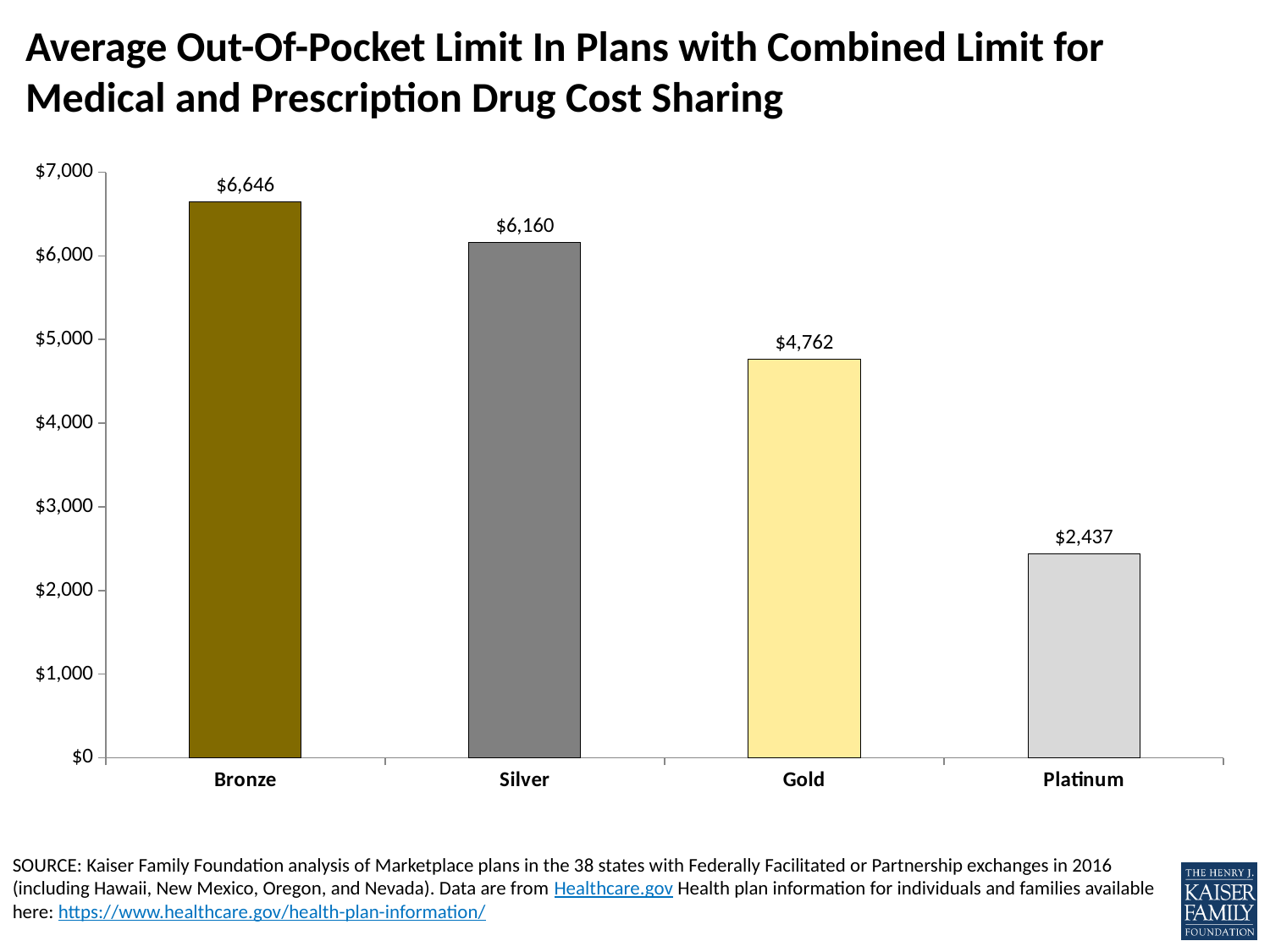
Is the value for Gold greater or less than $5,000? less What is the average out-of-pocket limit for Silver plans? $6,160 How many plan types are shown in the chart? 4 What is the difference between the average out-of-pocket limit for Silver and Gold plans? $1,398 What kind of chart is shown on the slide? Bar chart Which has a larger average out-of-pocket limit, Gold or Silver? Silver What is the average out-of-pocket limit for Platinum plans? $2,437 What is the difference between the average out-of-pocket limit for Bronze and Platinum plans? $4,209 Which plan type has the highest average out-of-pocket limit? Bronze What is the average out-of-pocket limit for Gold plans? $4,762 Which plan type has the lowest average out-of-pocket limit? Platinum What is the average out-of-pocket limit for Bronze plans? $6,646